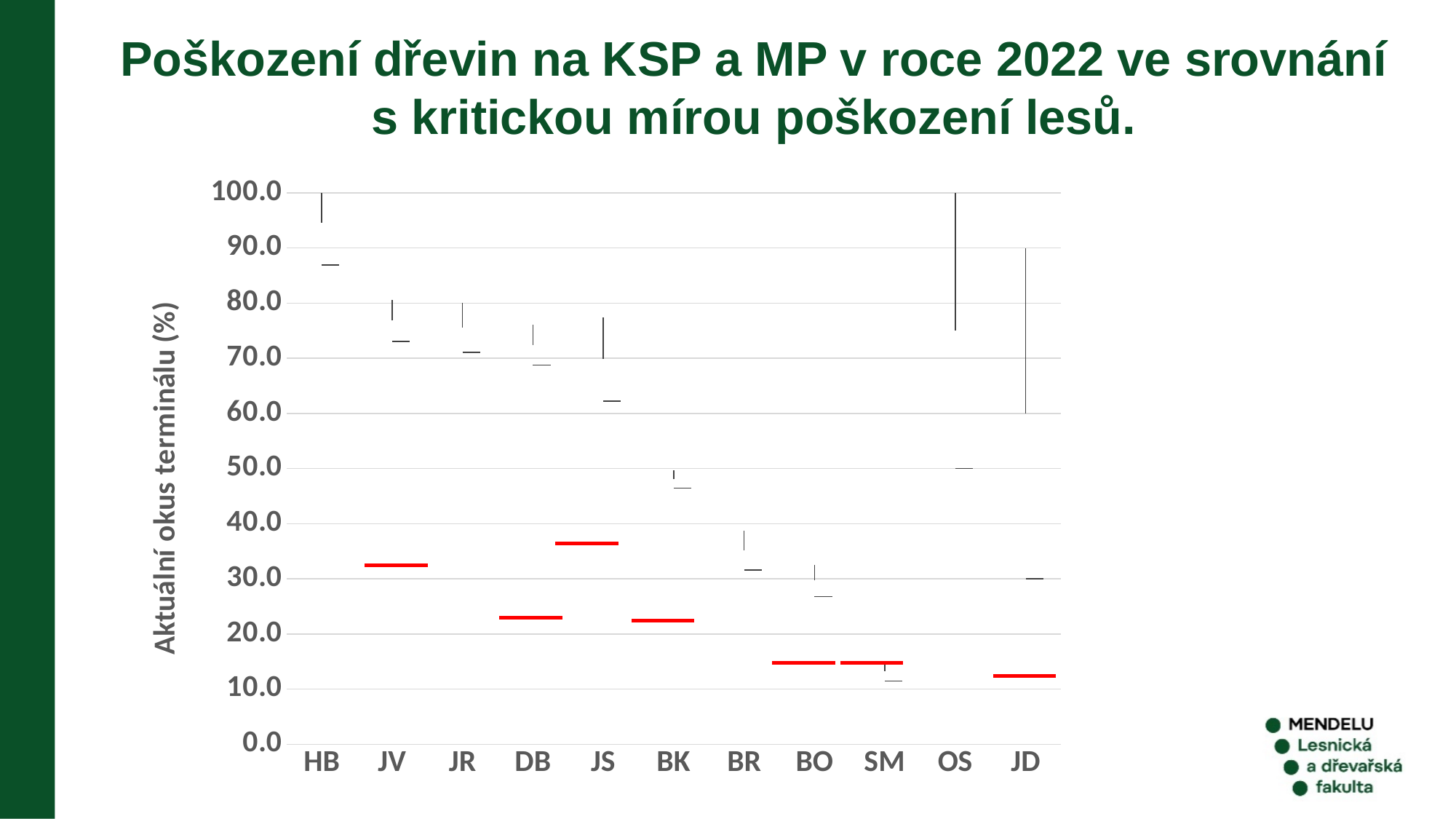
Is the red line value for SM greater or less than 20? less How many categories are shown on the x axis of the chart? 11 Which has the larger black marker value, HB or SM? HB Is the red line value for JS greater or less than 30? greater What is the title of the chart's vertical axis? Aktuální okus terminálu (%) Which category has the lowest plotted value on the chart? SM Do the black marker values generally rise or fall along the x axis from HB to SM? fall Is the black marker value for HB greater or less than 80? greater Which has the larger black marker value, BK or BR? BK How many categories have a red horizontal line plotted? 7